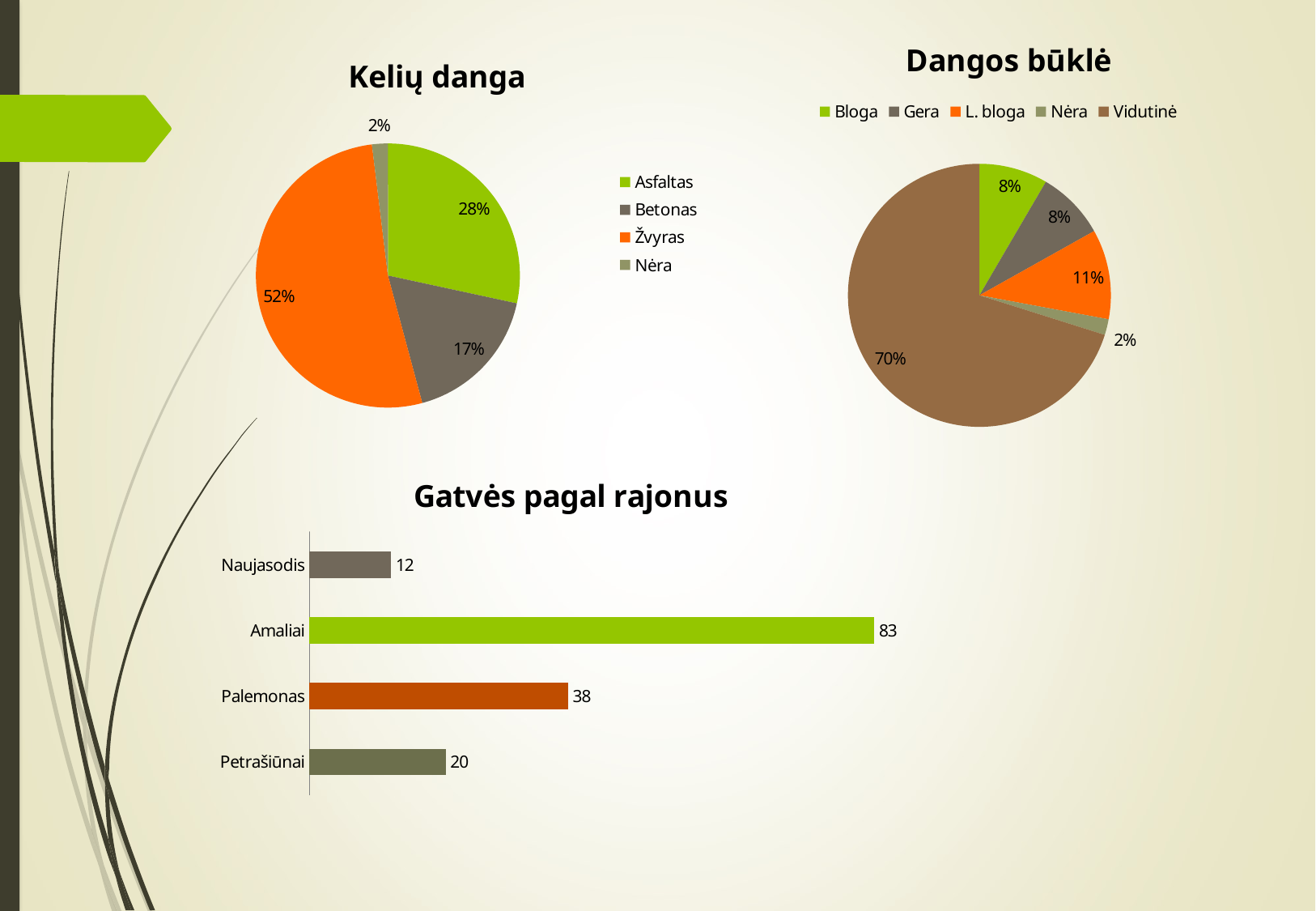
In the 'Gatvės pagal rajonus' chart, what is the difference between Amaliai and Naujasodis? 71 In the 'Kelių danga' chart, which category has the smallest slice? Nėra In the 'Dangos būklė' chart, what is the difference between the Vidutinė and L. bloga shares? 59% In the 'Kelių danga' chart, how many categories does the legend list? 4 In the 'Kelių danga' chart, what share of the pie is Žvyras? 52% In the 'Kelių danga' chart, what share of the pie is Betonas? 17% In the 'Gatvės pagal rajonus' chart, which district has the highest value? Amaliai In the 'Dangos būklė' chart, what share of the pie is L. bloga? 11% What kind of chart is 'Gatvės pagal rajonus'? Bar chart In the 'Dangos būklė' chart, which category has the largest slice? Vidutinė In the 'Gatvės pagal rajonus' chart, what is the value for Palemonas? 38